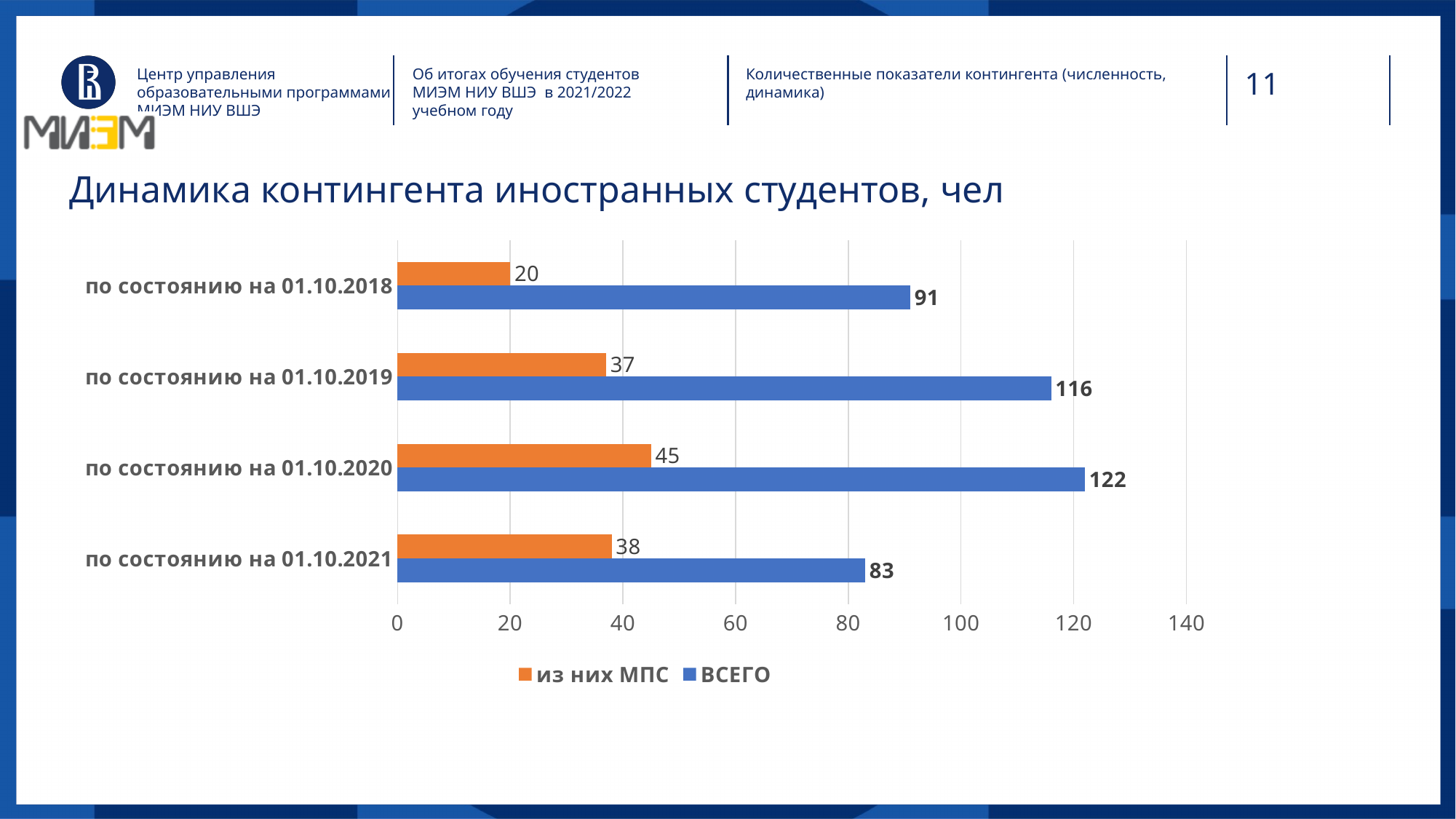
What is the из них МПС value for по состоянию на 01.10.2018? 20 What kind of chart is shown on the slide? bar chart Which date has the highest ВСЕГО value? по состоянию на 01.10.2020 How many series does the legend list? 2 How many dates (categories) are shown on the chart? 4 Which date has the lowest из них МПС value? по состоянию на 01.10.2018 What is the title of the chart? Динамика контингента иностранных студентов, чел What is the ВСЕГО value for по состоянию на 01.10.2020? 122 Which is larger: the из них МПС value for 01.10.2020 or for 01.10.2021? 01.10.2020 What is the difference between the ВСЕГО values for 01.10.2019 and 01.10.2018? 25 What is the ВСЕГО value for по состоянию на 01.10.2021? 83 Is the ВСЕГО value for по состоянию на 01.10.2019 greater or less than 100? greater